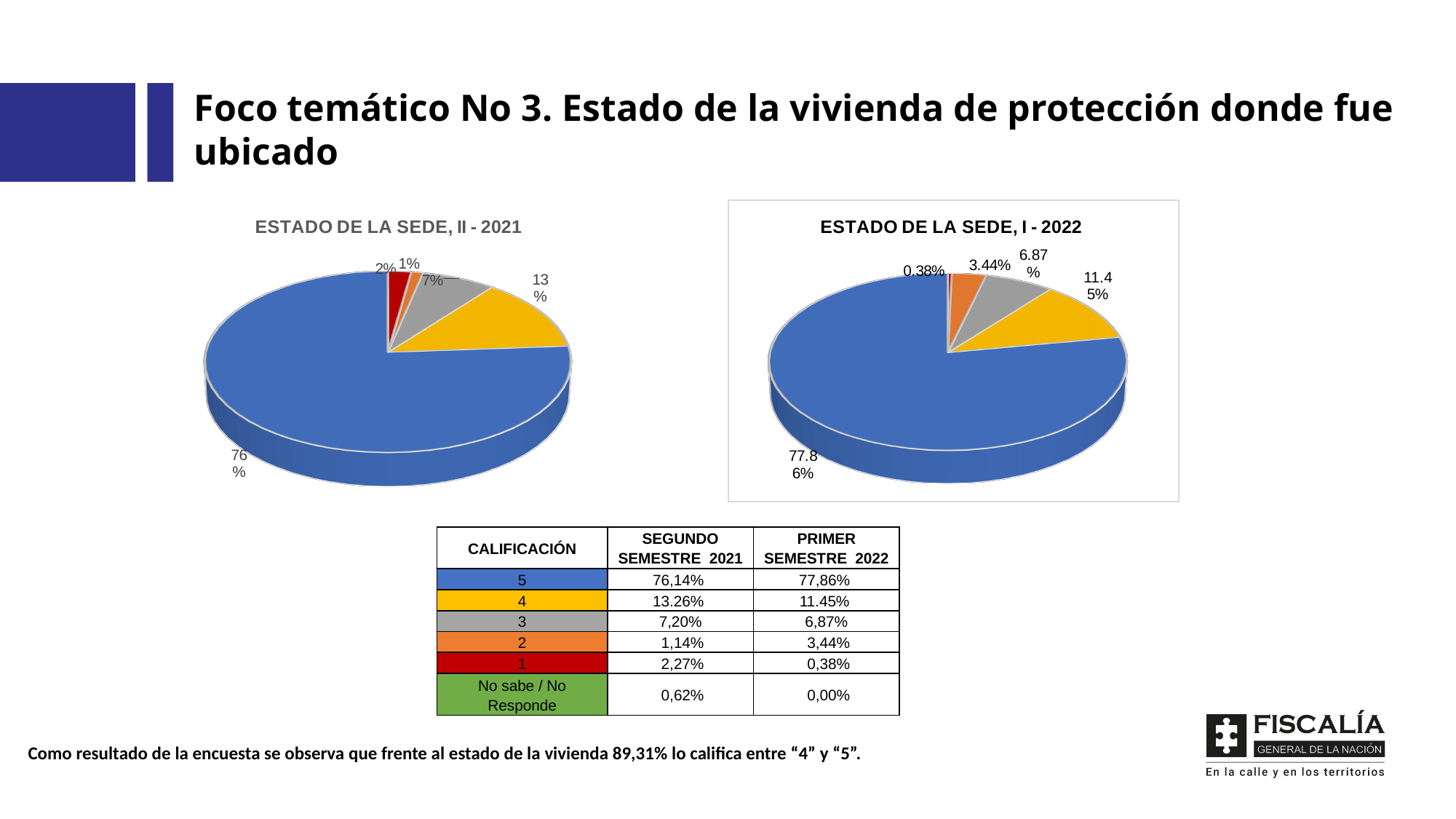
How many labeled slices does the chart "ESTADO DE LA SEDE, I - 2022" have? 5 In the chart "ESTADO DE LA SEDE, I - 2022", what value is shown on the yellow slice? 11.45% In the chart "ESTADO DE LA SEDE, II - 2021", what value is shown on the largest slice? 76% In the chart "ESTADO DE LA SEDE, I - 2022", what value is shown on the largest (blue) slice? 77.86% What is the title of the pie chart on the left of the slide? ESTADO DE LA SEDE, II - 2021 In the chart "ESTADO DE LA SEDE, I - 2022", what is the value of the smallest labeled slice? 0.38% Comparing the two pie charts, in which one is the blue slice larger? ESTADO DE LA SEDE, I - 2022 (77.86%) In the chart "ESTADO DE LA SEDE, I - 2022", what is the difference between the blue slice (77.86%) and the yellow slice (11.45%)? 66.41 percentage points What type of chart is "ESTADO DE LA SEDE, II - 2021"? Pie chart In the chart "ESTADO DE LA SEDE, I - 2022", which slice is larger, the gray one or the orange one? The gray one (6.87%) In the chart "ESTADO DE LA SEDE, II - 2021", what is the difference between the yellow slice (13%) and the gray slice (7%)? 6 percentage points In the chart "ESTADO DE LA SEDE, II - 2021", what is the value of the smallest labeled slice? 1%